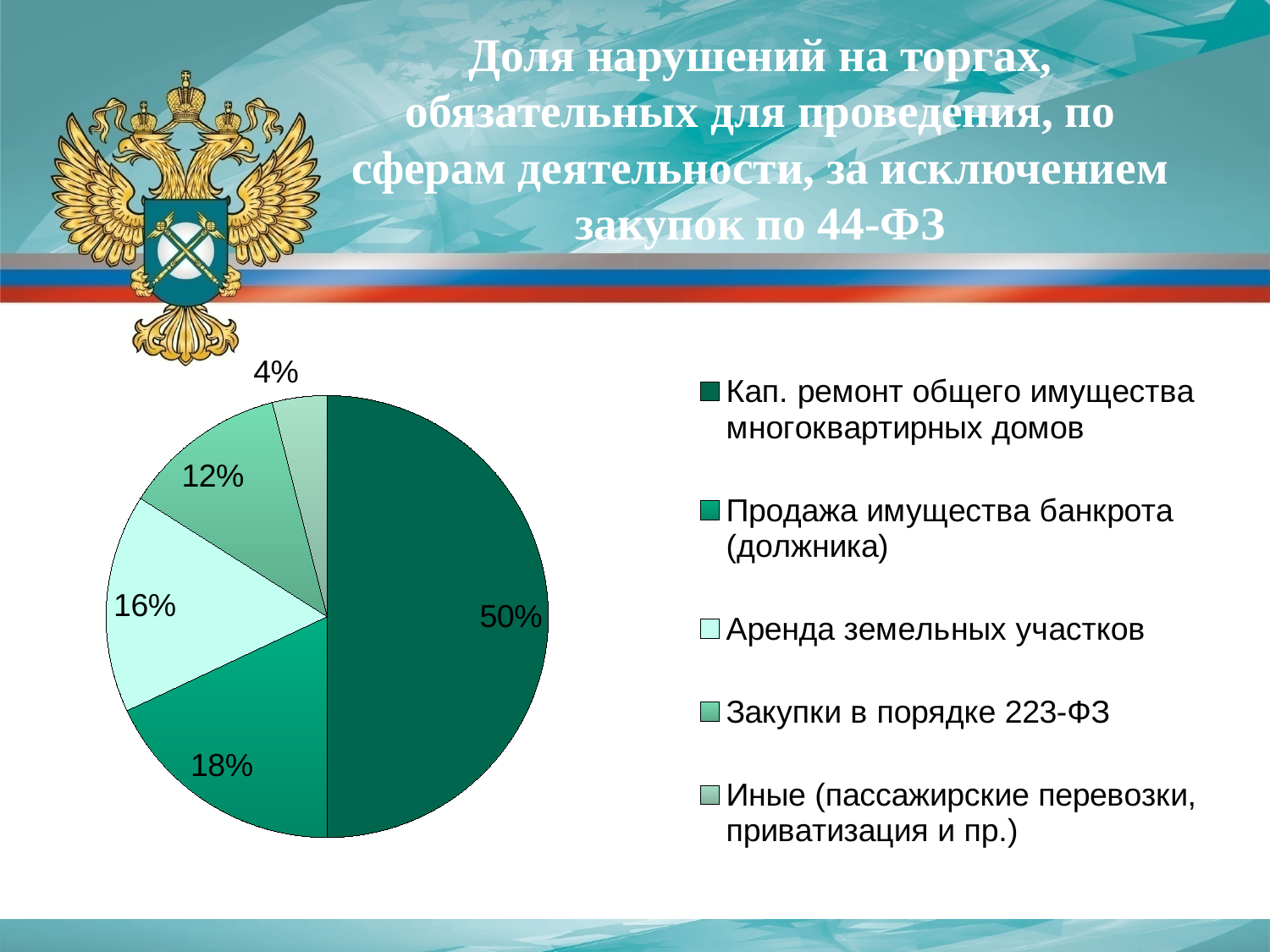
What share of violations is attributed to "Иные (пассажирские перевозки, приватизация и пр.)"? 4% What share of violations is attributed to "Аренда земельных участков"? 16% How many categories does the pie chart have? 5 What share of violations is attributed to "Кап. ремонт общего имущества многоквартирных домов"? 50% What share of violations is attributed to "Продажа имущества банкрота (должника)"? 18% What is the combined share of "Аренда земельных участков" and "Закупки в порядке 223-ФЗ"? 28% Which category has the largest share of the pie? Кап. ремонт общего имущества многоквартирных домов What share of violations is attributed to "Закупки в порядке 223-ФЗ"? 12% What is the difference in percentage points between "Кап. ремонт общего имущества многоквартирных домов" and "Продажа имущества банкрота (должника)"? 32 percentage points Which has a larger share: "Аренда земельных участков" or "Закупки в порядке 223-ФЗ"? Аренда земельных участков Which category has the smallest share of the pie? Иные (пассажирские перевозки, приватизация и пр.) What kind of chart is shown on the slide? pie chart